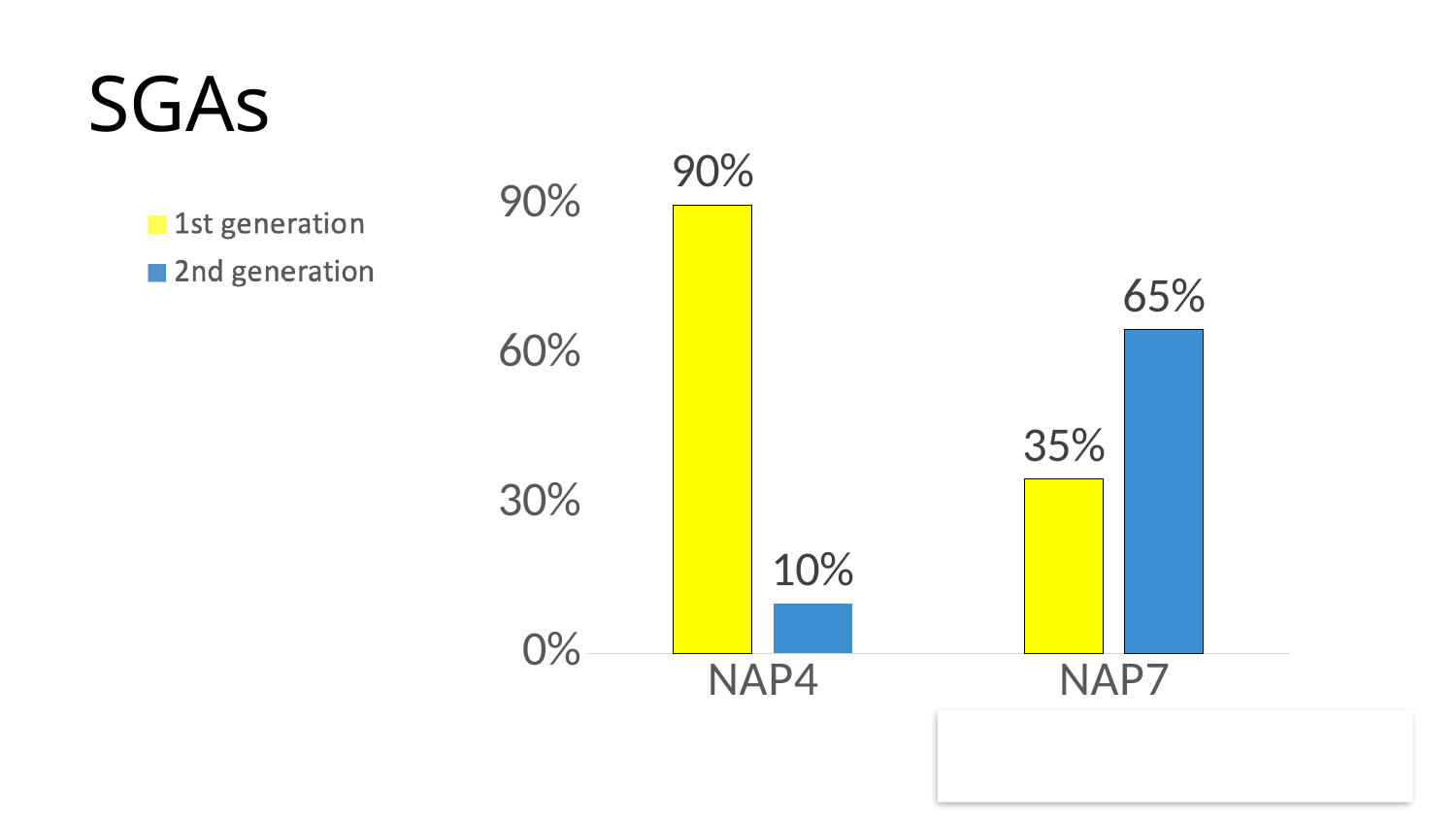
What is the difference between the 1st generation and 2nd generation values at NAP4? 80% What is the value for 2nd generation at NAP7? 65% What is the difference between the 2nd generation and 1st generation values at NAP7? 30% What is the value for 1st generation at NAP7? 35% What is the value for 1st generation at NAP4? 90% How many categories are shown on the x axis? 2 How many series does the legend list? 2 What is the value for 2nd generation at NAP4? 10% Which category has the lowest 2nd generation value? NAP4 What kind of chart is shown on the slide? Bar chart Which category has the highest 1st generation value? NAP4 At NAP7, which is larger: 1st generation or 2nd generation? 2nd generation